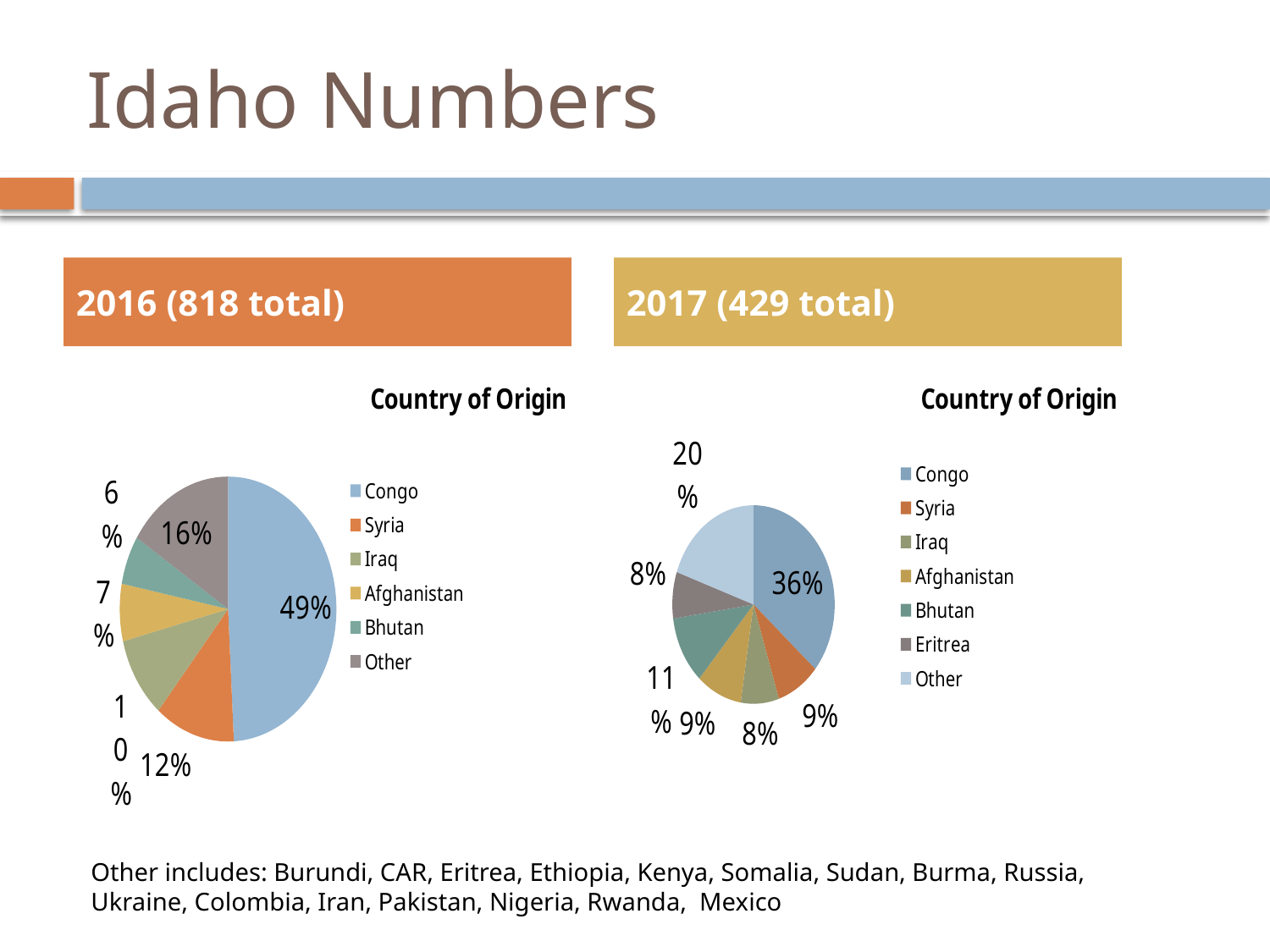
In the 2016 Country of Origin chart, what share of the pie is Congo? 49% In the 2016 Country of Origin chart, which category has the smallest slice? Bhutan How many categories does the legend of the 2016 Country of Origin chart list? 6 In the 2016 Country of Origin chart, what percentage is shown for Syria? 12% In the 2017 Country of Origin chart, what percentage is shown for Other? 20% What is the difference in percentage points between Congo's share in the 2016 chart and Congo's share in the 2017 chart? 13 In the 2017 Country of Origin chart, what percentage is shown for Bhutan? 11% In the 2017 Country of Origin chart, which is larger, the slice for Bhutan or the slice for Syria? Bhutan How many categories does the legend of the 2017 Country of Origin chart list? 7 In the 2017 Country of Origin chart, what share of the pie is Congo? 36% What type of chart is used for the 2017 Country of Origin data? Pie chart In the 2016 Country of Origin chart, which country has the largest slice? Congo